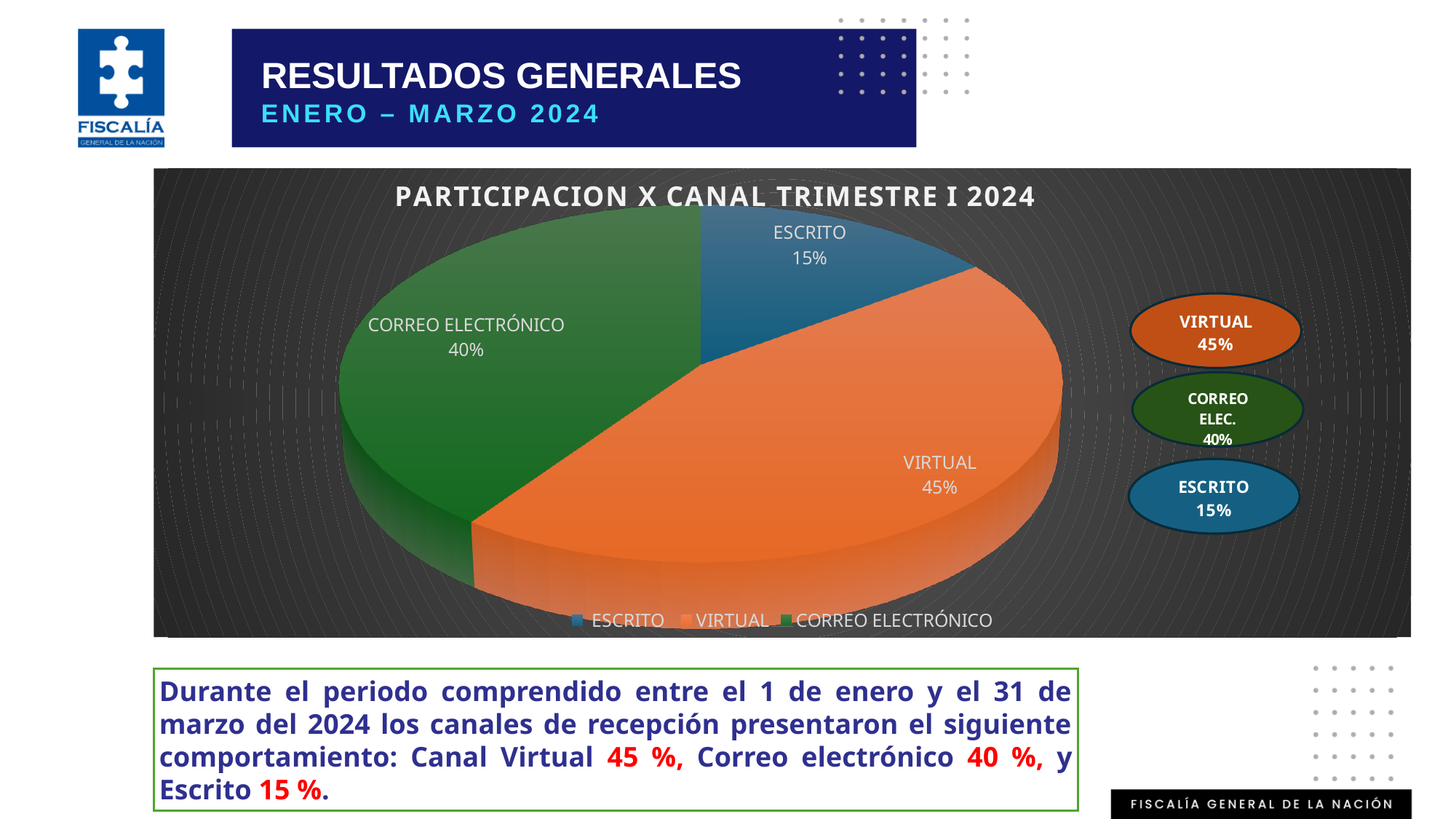
What percentage does the VIRTUAL slice represent? 45% Which channel has the smallest share of the pie? ESCRITO What percentage does the ESCRITO slice represent? 15% How many entries does the legend list? 3 What is the title of the chart? PARTICIPACION X CANAL TRIMESTRE I 2024 What colour is the VIRTUAL slice in the pie chart? Orange How many slices does the pie chart have? 3 Which channel has the largest share of the pie? VIRTUAL What percentage does the CORREO ELECTRÓNICO slice represent? 40% What type of chart is shown on the slide? Pie chart Which is larger, the share for CORREO ELECTRÓNICO or the share for ESCRITO? CORREO ELECTRÓNICO What is the difference in percentage points between VIRTUAL and ESCRITO? 30